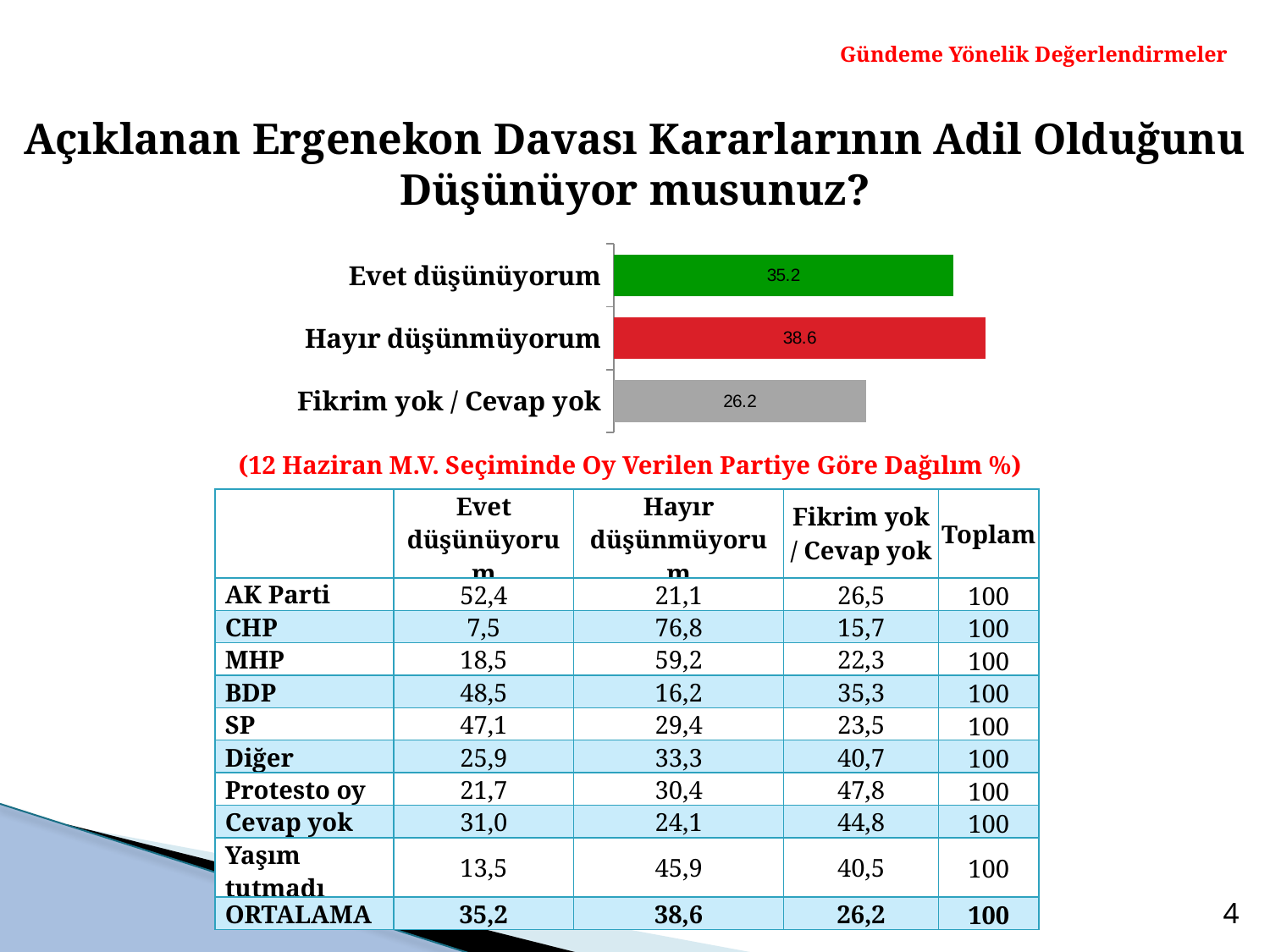
What colour is the bar for "Hayır düşünmüyorum" in the bar chart? Red Which category has the highest value in the bar chart? Hayır düşünmüyorum How many categories are shown in the bar chart? 3 What is the difference between the values for "Evet düşünüyorum" and "Fikrim yok / Cevap yok" in the bar chart? 9.0 What is the difference between the values for "Hayır düşünmüyorum" and "Evet düşünüyorum" in the bar chart? 3.4 What is the value for "Hayır düşünmüyorum" in the bar chart? 38.6 What colour is the bar for "Evet düşünüyorum" in the bar chart? Green What kind of chart is shown on the slide? Bar chart What is the value for "Evet düşünüyorum" in the bar chart? 35.2 Which is larger in the bar chart: the value for "Evet düşünüyorum" or the value for "Fikrim yok / Cevap yok"? Evet düşünüyorum Which category has the lowest value in the bar chart? Fikrim yok / Cevap yok What is the value for "Fikrim yok / Cevap yok" in the bar chart? 26.2